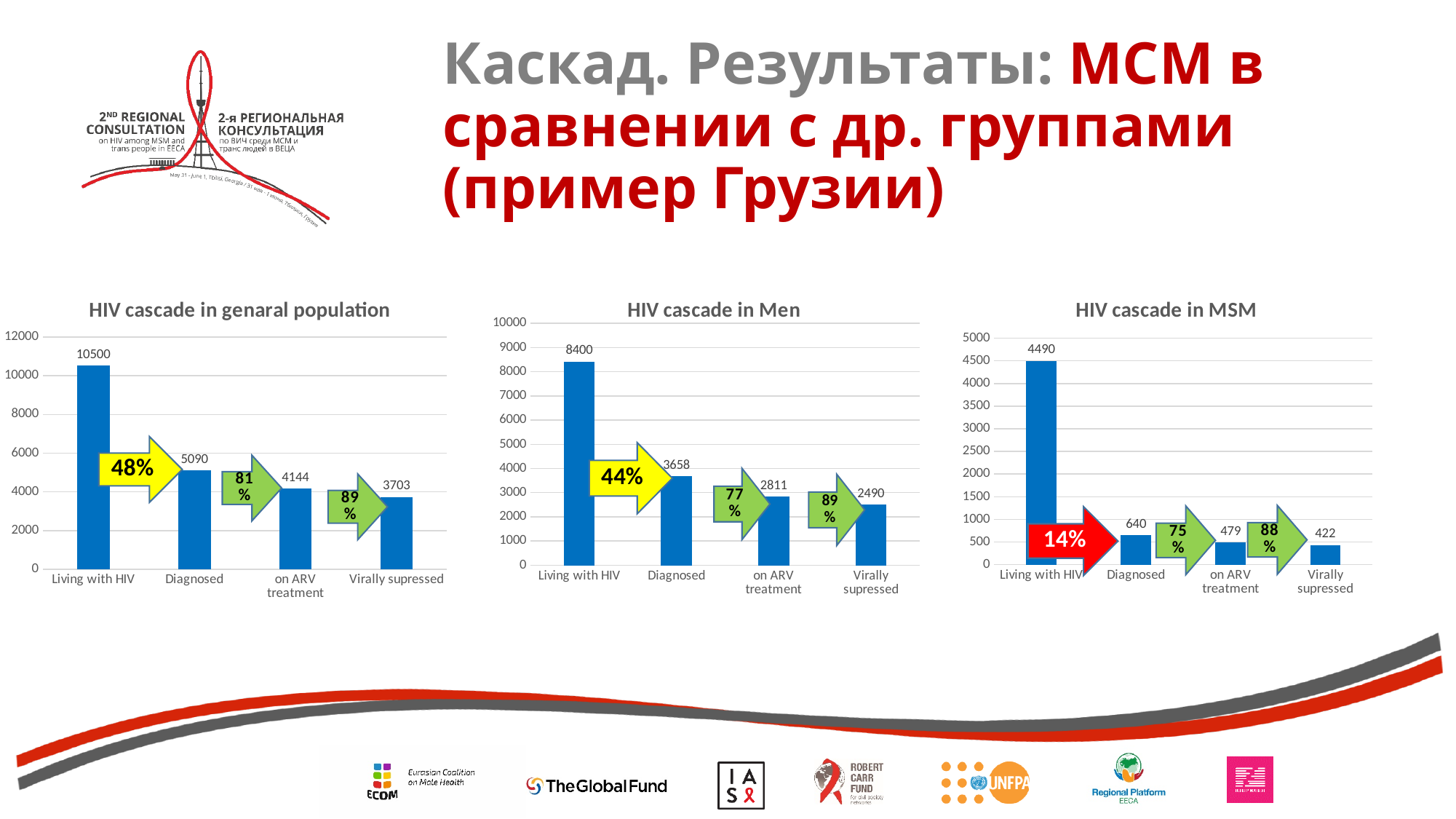
In the 'HIV cascade in MSM' chart, what percentage is shown on the red arrow between Living with HIV and Diagnosed? 14% In the 'HIV cascade in Men' chart, which category has the highest value? Living with HIV In the 'HIV cascade in genaral population' chart, what is the difference between Diagnosed and on ARV treatment? 946 In the 'HIV cascade in Men' chart, which is larger: on ARV treatment or Virally supressed? on ARV treatment In the 'HIV cascade in genaral population' chart, what is the value for Living with HIV? 10500 In the 'HIV cascade in MSM' chart, what is the value for Virally supressed? 422 In the 'HIV cascade in MSM' chart, which category has the lowest value? Virally supressed In the 'HIV cascade in MSM' chart, what is the difference between Living with HIV and Diagnosed? 3850 In the 'HIV cascade in genaral population' chart, do the values rise or fall from left to right? Fall How many categories are shown in the 'HIV cascade in MSM' chart? 4 In the 'HIV cascade in Men' chart, what is the value for Diagnosed? 3658 What kind of chart is 'HIV cascade in Men'? Bar chart